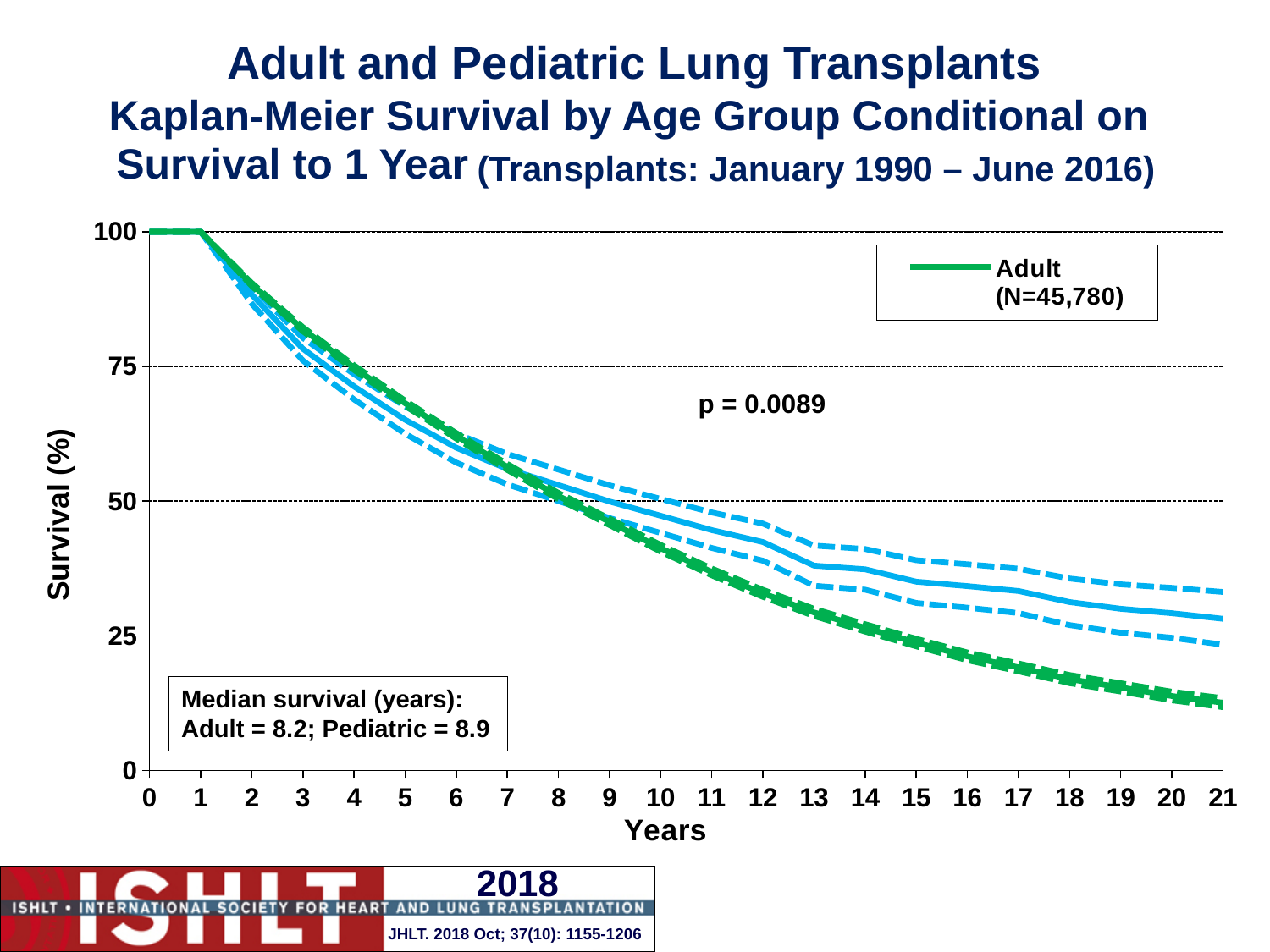
What is the difference in median survival (years) between the Pediatric and Adult groups? 0.7 Is the Adult survival at 17 years greater or less than 25? less Is the Adult survival at 5 years greater or less than 50? greater What is the median survival in years for the Adult group? 8.2 What is the median survival in years for the Pediatric group? 8.9 Which group has the longer median survival, Adult or Pediatric? Pediatric Does survival rise or fall as the number of years increases? fall What is the label of the y-axis? Survival (%) What p-value is printed on the chart? p = 0.0089 What kind of chart is shown on the slide? line chart How many series does the legend list? 1 What is the N for the Adult group shown in the legend? 45,780